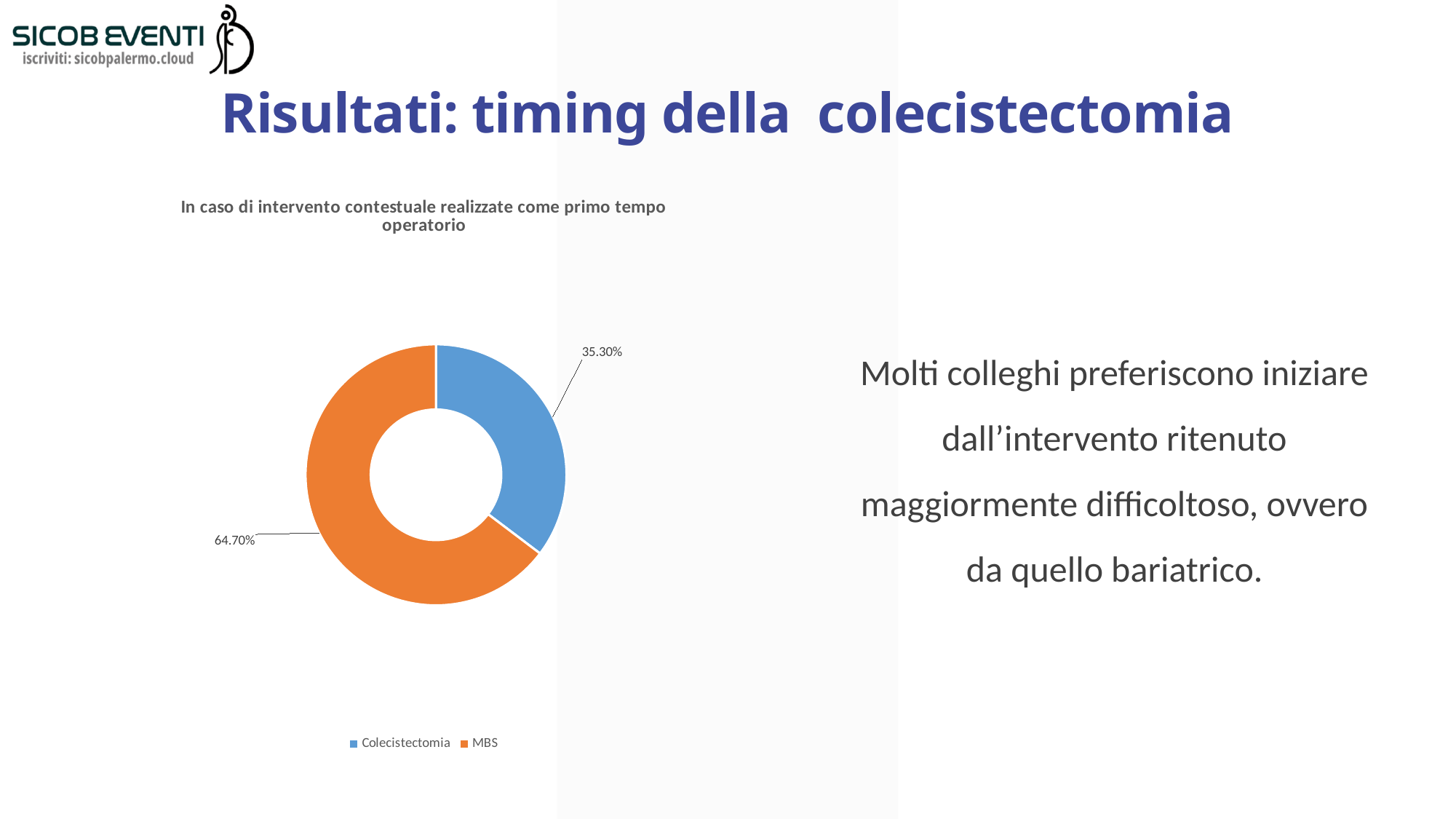
What share of the chart does Colecistectomia represent? 35.30% Which category has the largest share in the chart? MBS What is the difference in percentage points between the MBS share and the Colecistectomia share? 29.40% Which category has the smallest share in the chart? Colecistectomia What is the title of the chart? In caso di intervento contestuale realizzate come primo tempo operatorio What kind of chart is shown on the slide? Doughnut (pie) chart What is the total of the two shares shown in the chart? 100% What share of the chart does MBS represent? 64.70% Which colour represents MBS in the chart? Orange Which is larger, the share for Colecistectomia or the share for MBS? MBS How many categories does the chart show? 2